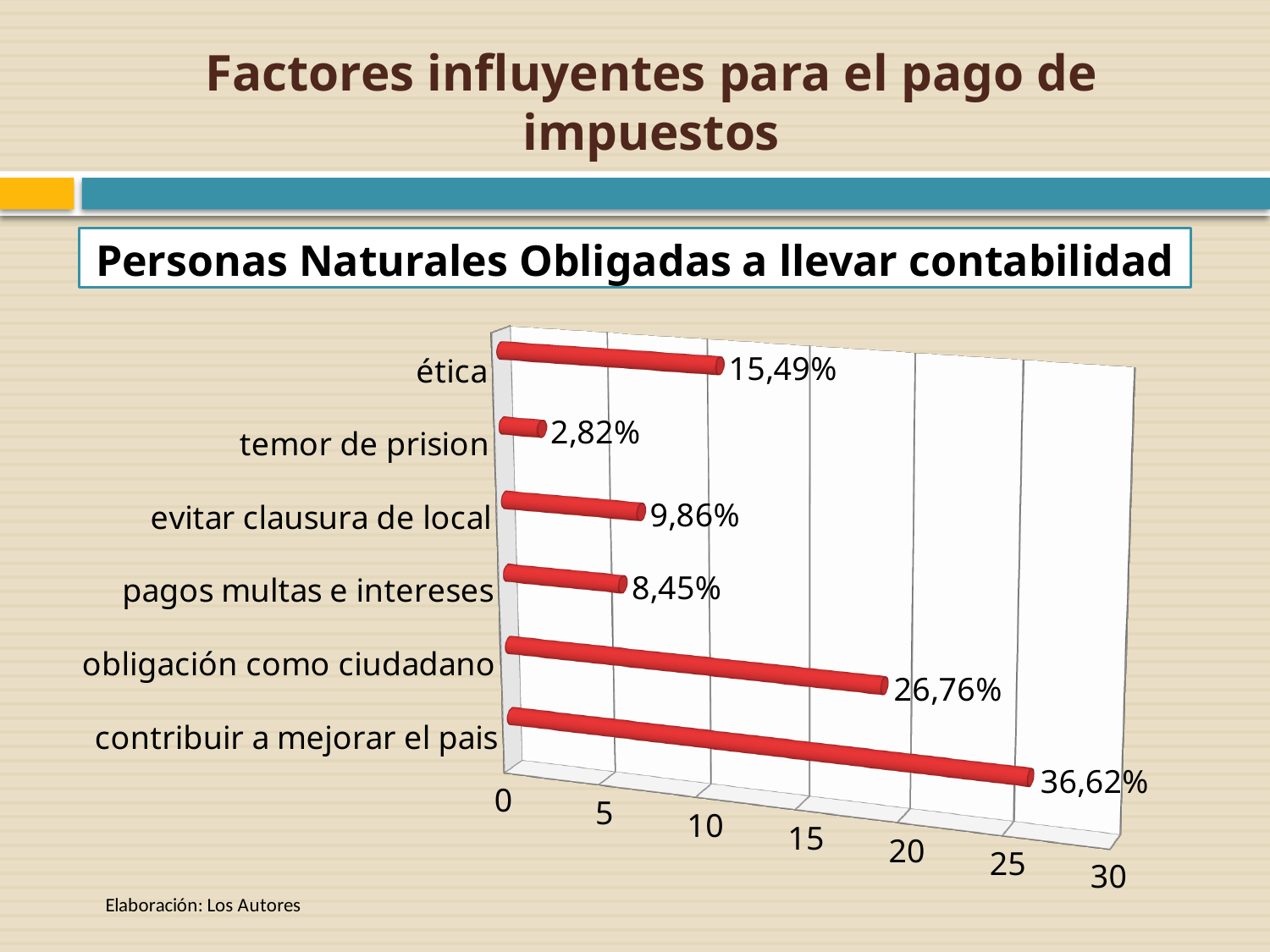
What is the value for "temor de prision"? 2,82% Which is larger, the value for "evitar clausura de local" or the value for "pagos multas e intereses"? evitar clausura de local What is the value for "ética"? 15,49% How many categories are shown in the chart? 6 What is the value for "obligación como ciudadano"? 26,76% Which category has the highest value? contribuir a mejorar el pais Which category has the lowest value? temor de prision What is the value for "pagos multas e intereses"? 8,45% What is the difference between the values for "ética" and "temor de prision"? 12,67% What is the title shown in the box above the chart? Personas Naturales Obligadas a llevar contabilidad What is the difference between the values for "contribuir a mejorar el pais" and "obligación como ciudadano"? 9,86% What kind of chart is shown on the slide? bar chart